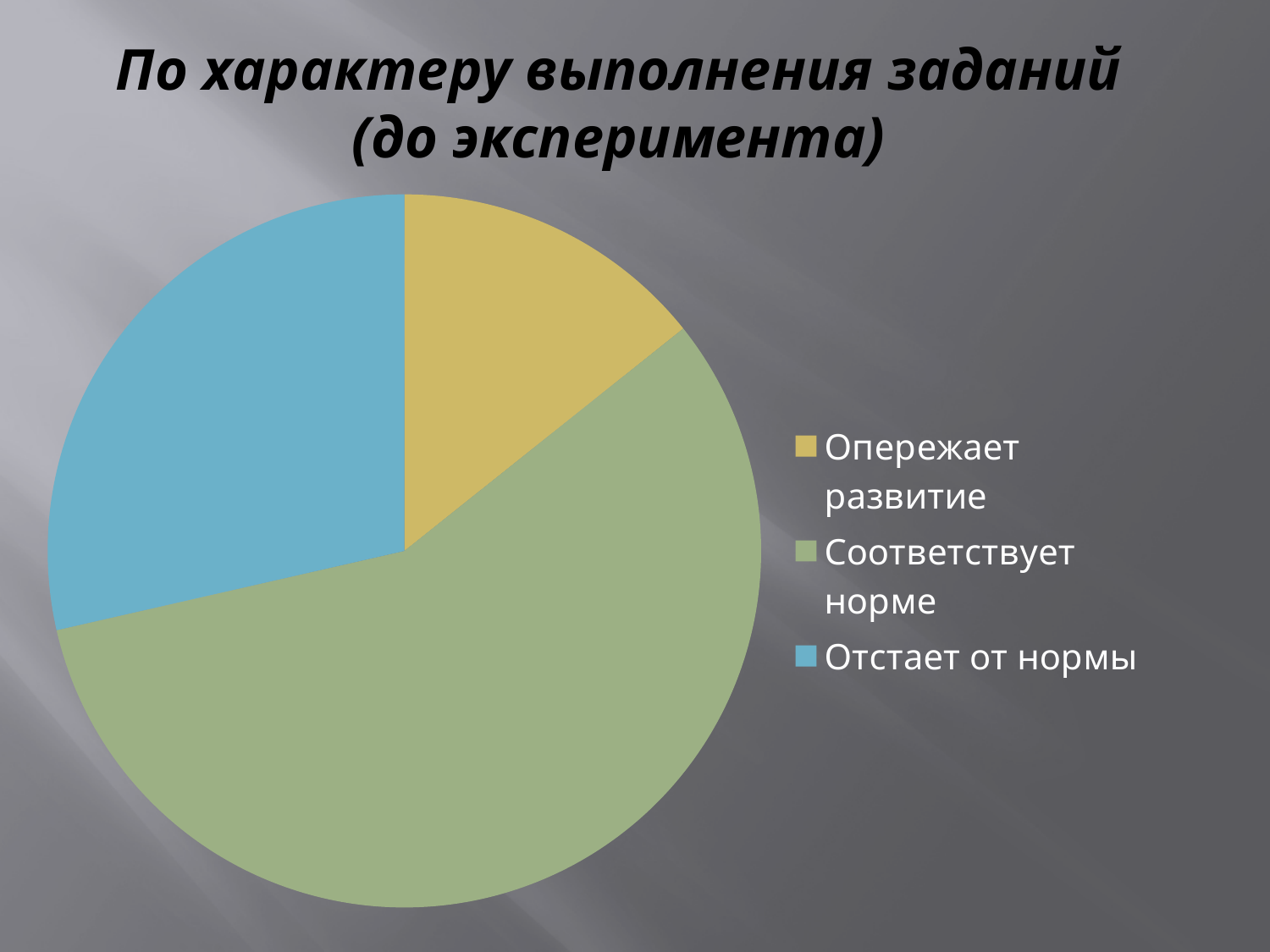
Which category has the smallest slice of the pie? Опережает развитие Which slice is larger: Соответствует норме or Отстает от нормы? Соответствует норме Which category has the largest slice of the pie? Соответствует норме Which slice is larger: Отстает от нормы or Опережает развитие? Отстает от нормы What colour is the slice for Отстает от нормы? blue How many entries does the legend list? 3 What kind of chart is shown on the slide? pie chart What is the title of the slide? По характеру выполнения заданий (до эксперимента) How many slices does the pie chart have? 3